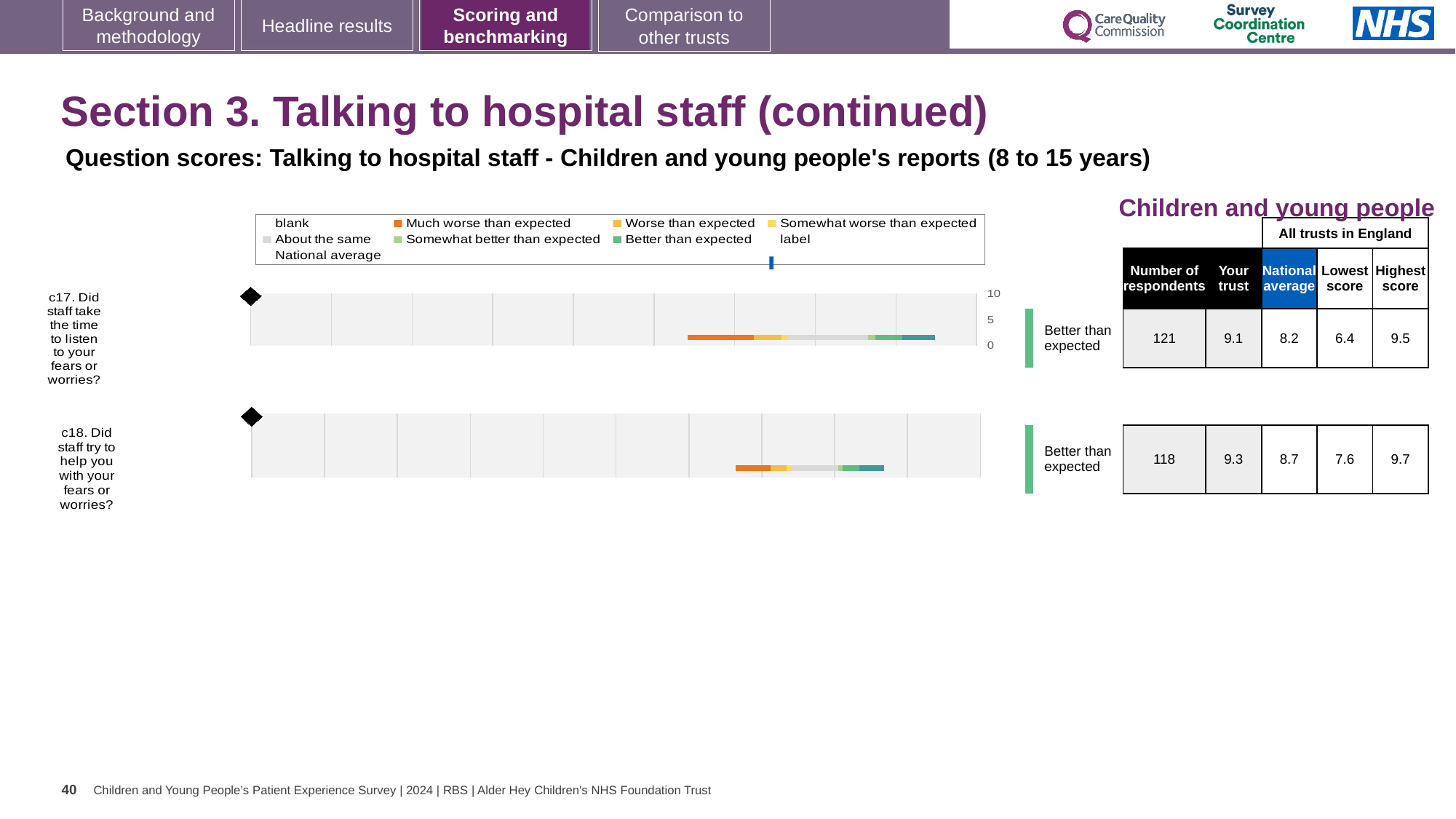
What is the difference between the highest and lowest scores for question c18? 2.1 Which colour in the legend represents 'Much worse than expected'? orange What is the lowest score among all trusts in England for question c18? 7.6 What is the national average score for question c17? 8.2 How many survey questions are plotted on the slide? 2 What benchmark category is shown for question c17? Better than expected Which question has the higher 'Your trust' score, c17 or c18? c18 What is the highest score among all trusts in England for question c17? 9.5 What is the 'Your trust' score for question c18 (Did staff try to help you with your fears or worries?)? 9.3 By how much does the trust's score for c17 exceed the national average for c17? 0.9 What is the number of respondents for question c17 (Did staff take the time to listen to your fears or worries?)? 121 What type of chart is used to show the question scores for c17 and c18? bar chart